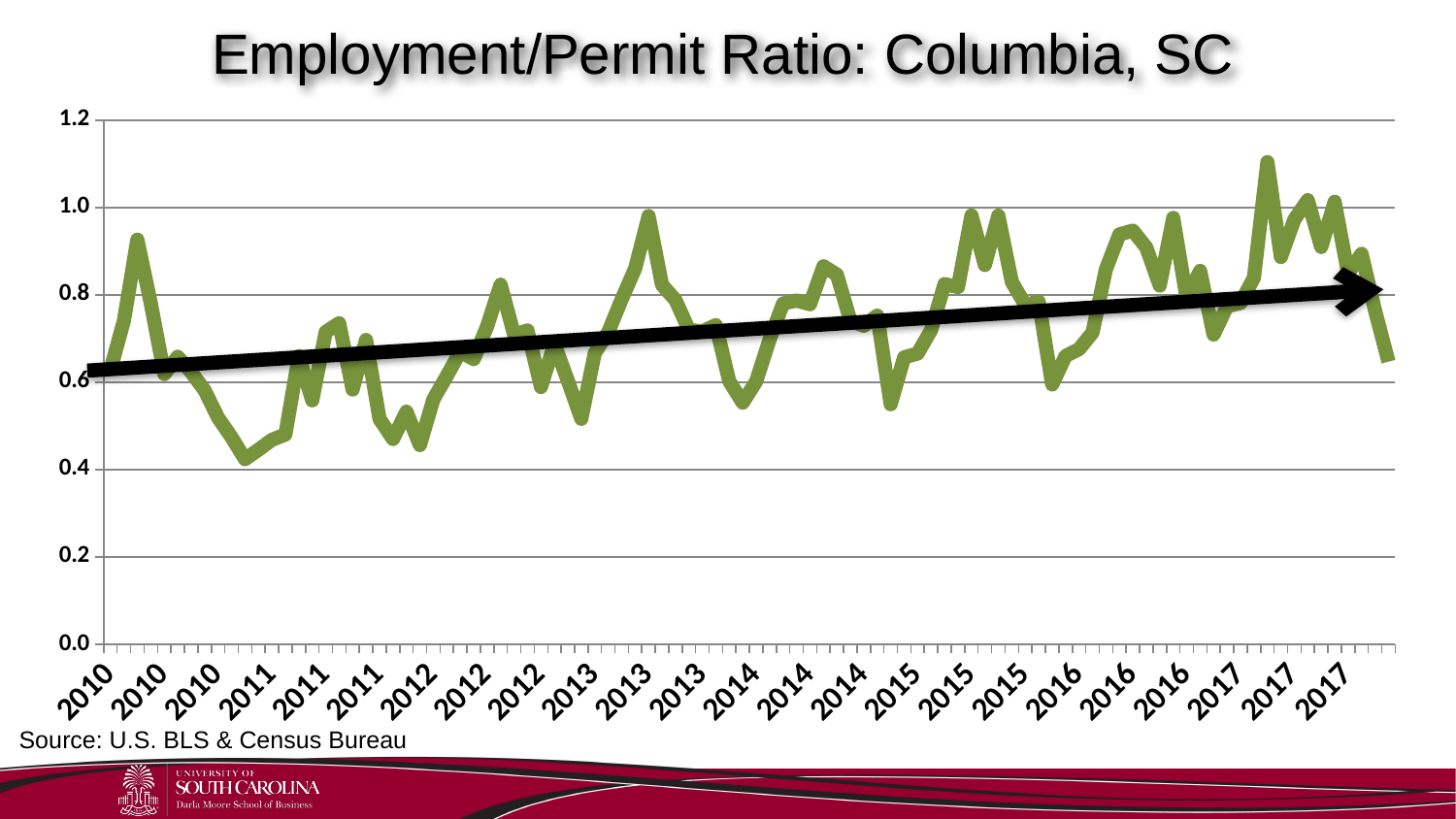
Is the peak value in 2010 greater or less than 0.8? greater Is the peak value in 2013 greater or less than 1.2? less Is the lowest value reached in 2011 greater or less than 0.6? less What is the title of the chart? Employment/Permit Ratio: Columbia, SC What is the source cited for the chart data? U.S. BLS & Census Bureau Does the overall trend of the employment/permit ratio rise or fall from 2010 to 2017? rise In which year does the line reach its highest value? 2017 What is the maximum value shown on the vertical axis? 1.2 What kind of chart is shown on the slide? line chart How many year labels are shown along the x axis? 24